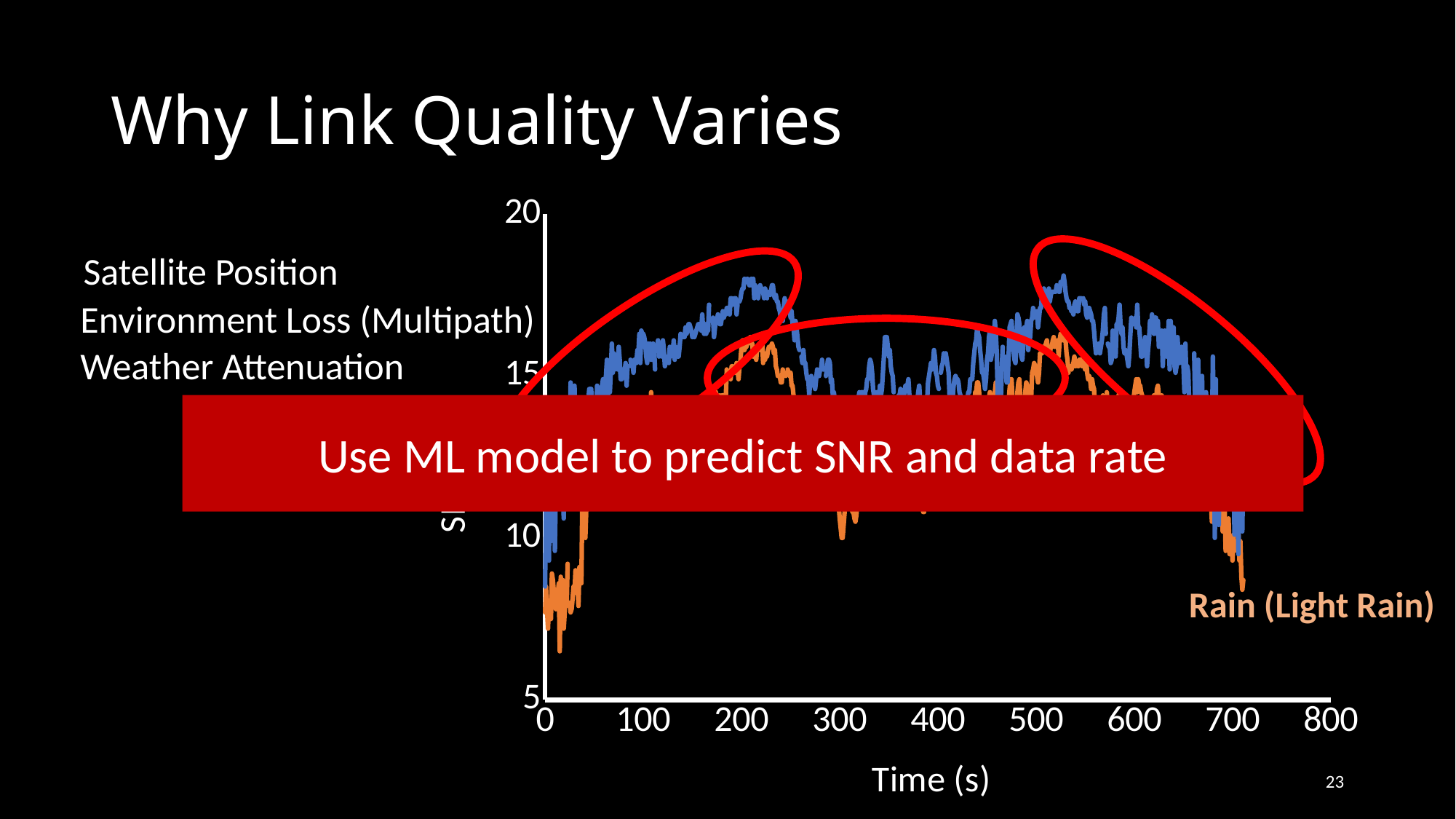
Is the value of the orange series near time 20 s greater or less than 10? less How many tick labels are shown along the x axis of the chart? 9 What kind of chart is shown on the slide? line chart Is the peak value of the blue series around time 200 s greater or less than 15? greater What is the highest tick value shown on the y axis of the chart? 20 What is the largest tick value shown on the x axis of the chart? 800 What is the lowest tick value shown on the y axis of the chart? 5 Which series colour is labelled "Rain (Light Rain)" on the chart? orange Does the blue series rise or fall between time 0 s and time 200 s? rise What is the label of the x axis of the chart? Time (s) Does the blue series rise or fall between time 600 s and time 700 s? fall Around time 200 s, which series is higher, the blue series or the orange series? blue